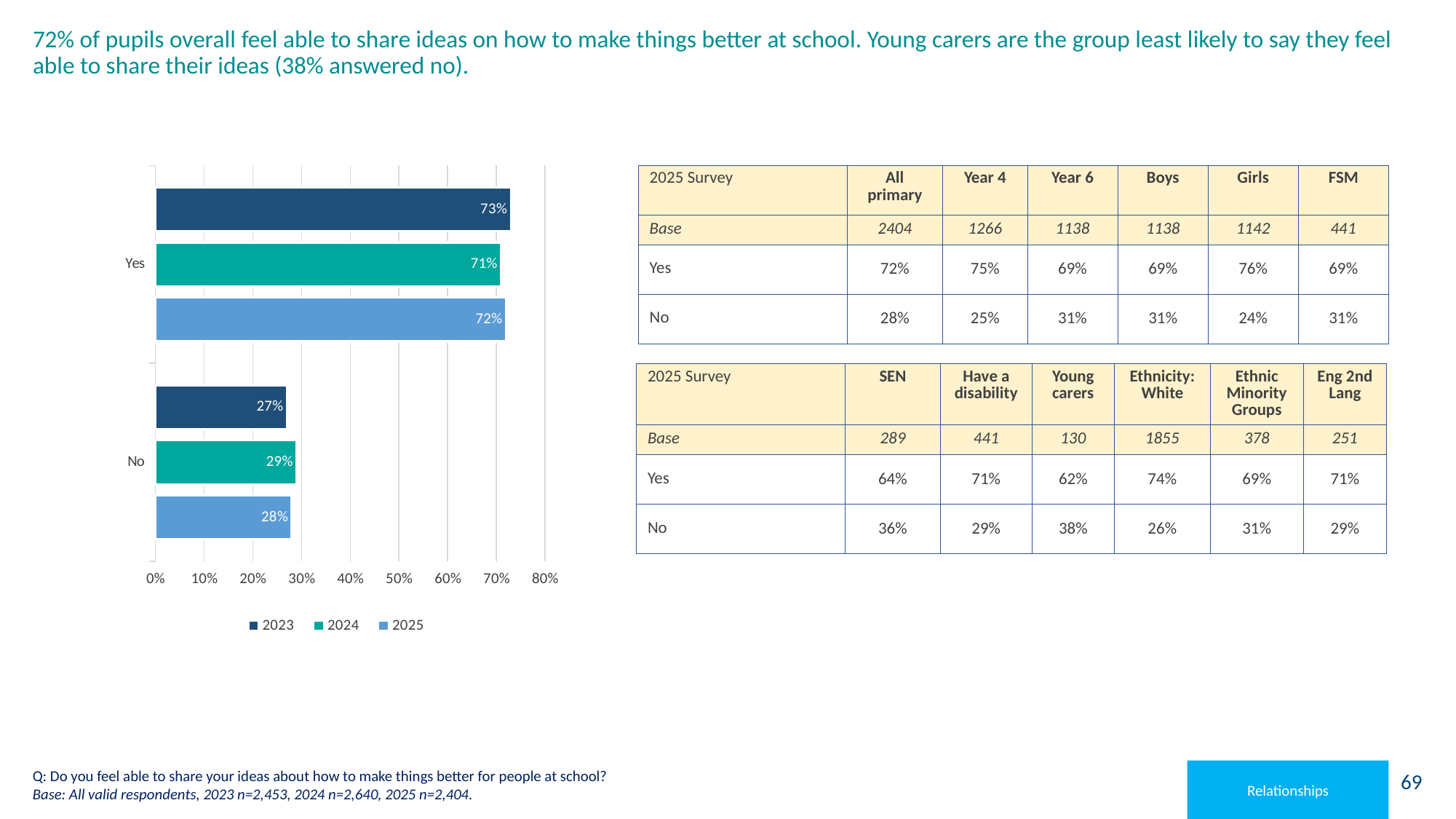
What is the value for Yes in 2025? 72% Is the value for Yes in 2024 greater or less than 60%? greater How many series does the legend list? 3 Which year has the highest value for Yes? 2023 What is the value for No in 2024? 29% What kind of chart is shown on the slide? bar chart How many categories are shown on the chart's vertical axis? 2 Which year has the lowest value for No? 2023 What is the difference between the Yes and No values for 2025? 44% Which is larger, the No value for 2024 or the No value for 2023? 2024 What is the value for No in 2025? 28% What is the value for Yes in 2023? 73%